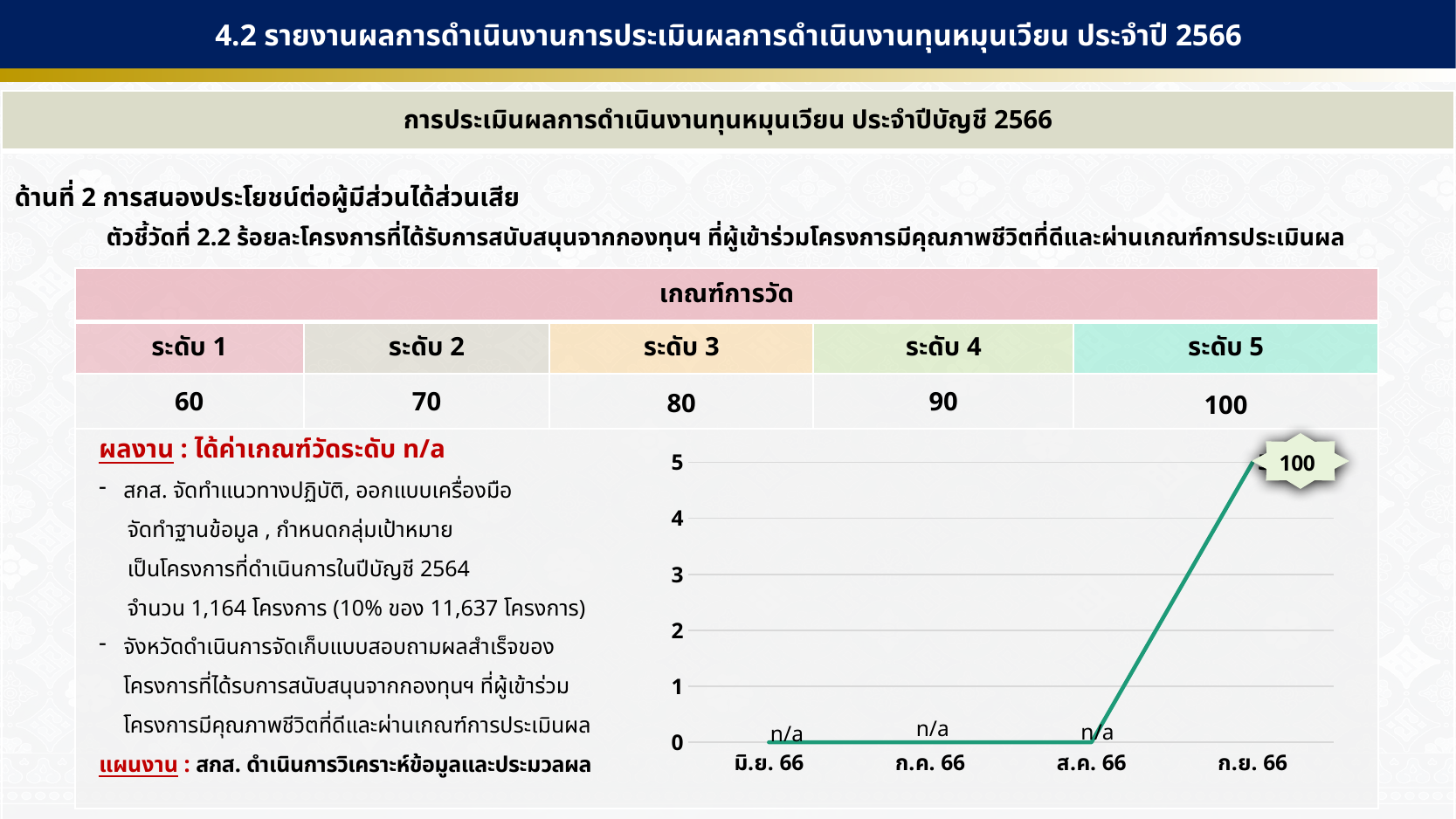
How many data points are plotted along the x axis of the chart? 4 What is the highest tick value shown on the y axis of the chart? 5 Is the plotted value for ก.ค. 66 greater or less than 1? less What kind of chart is shown on the slide? line chart What data label is shown for ก.ย. 66 in the chart? 100 What is the first category label on the x axis of the chart? มิ.ย. 66 What y-axis tick does the plotted point for ก.ย. 66 land on? 5 Does the line rise or fall between ส.ค. 66 and ก.ย. 66? rise Is the plotted value for ก.ย. 66 greater or less than 4? greater Which category has the highest plotted value in the chart? ก.ย. 66 What data label is shown for มิ.ย. 66 in the chart? n/a What data label is shown for ส.ค. 66 in the chart? n/a